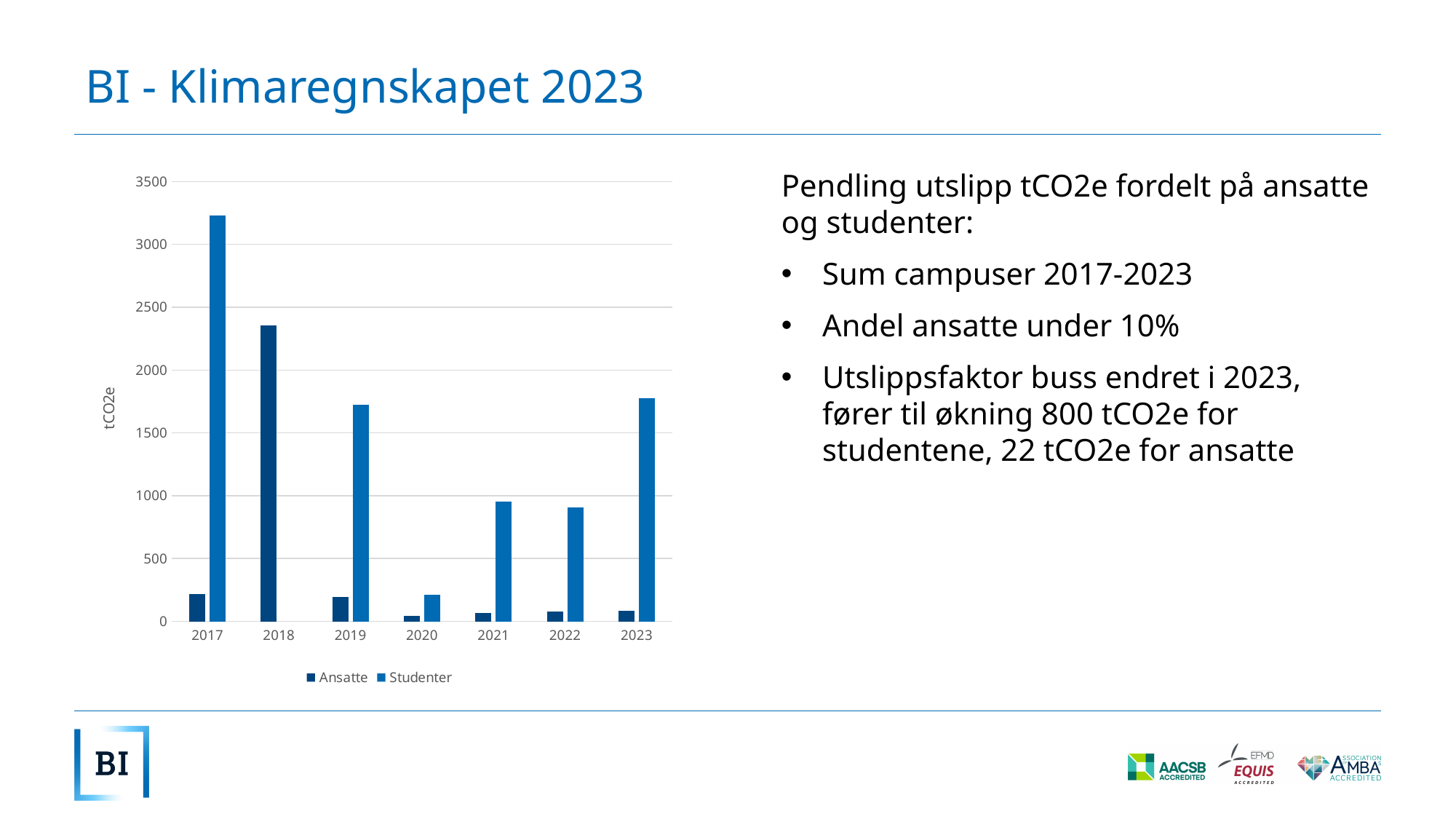
Is the Studenter value for 2017 greater or less than 3000? greater Is the Ansatte value for 2017 greater or less than 500? less In which year is the Studenter value lowest? 2020 What are the two series named in the chart legend? Ansatte and Studenter Which is larger, the Studenter value for 2017 or for 2019? 2017 Is the Studenter value for 2020 greater or less than 500? less How many series does the chart legend list? 2 What kind of chart is shown on the slide? bar chart What is the label on the vertical axis of the chart? tCO2e In which year is the Studenter value highest? 2017 How many years are shown on the x axis of the chart? 7